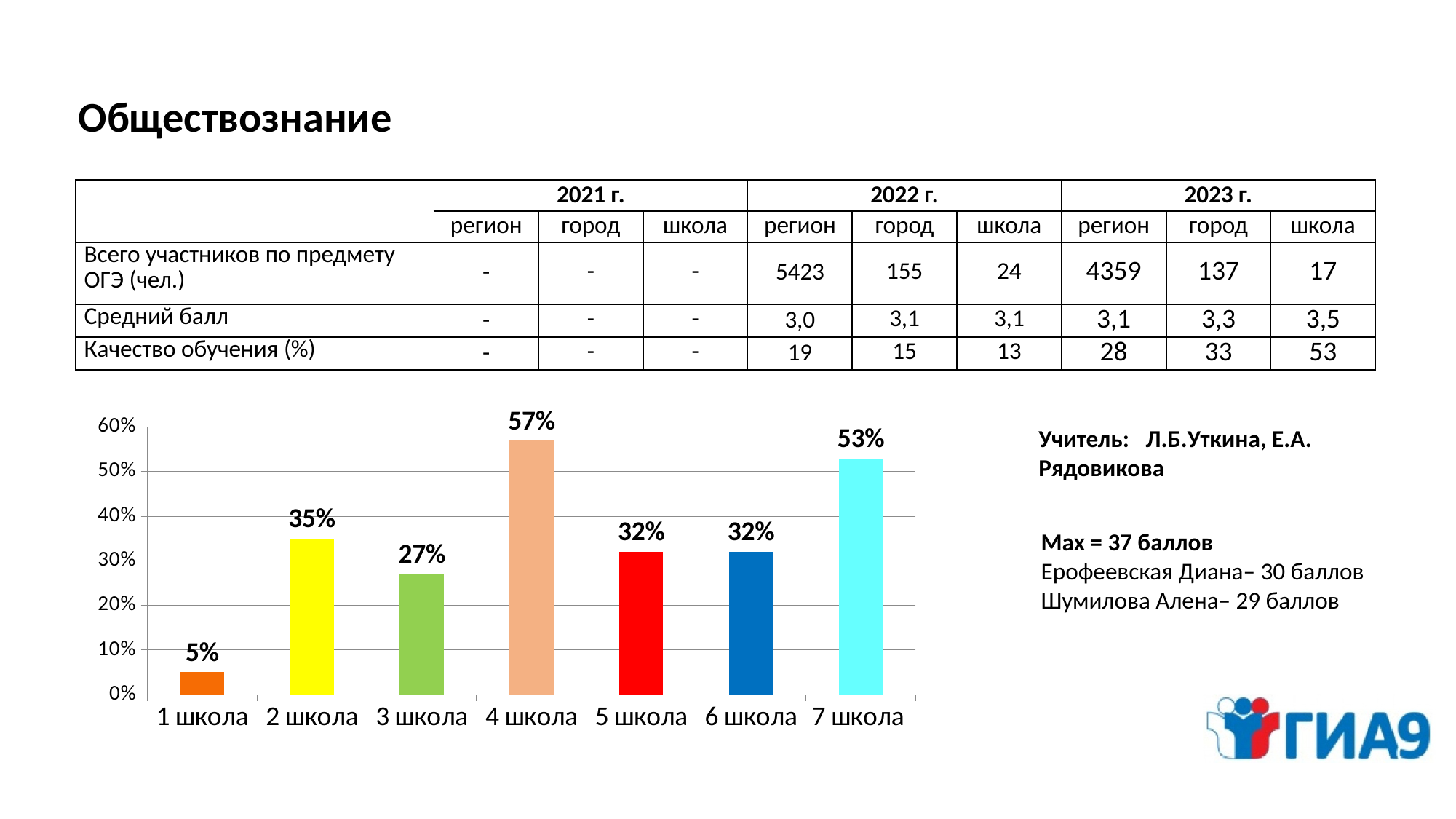
Which school has the highest value in the bar chart? 4 школа What is the value for 1 школа in the bar chart? 5% What is the value for 7 школа in the bar chart? 53% What kind of chart is shown on the slide? bar chart What colour is the bar for 5 школа? red Which school has the lowest value in the bar chart? 1 школа Which is larger, the value for 2 школа or the value for 5 школа? 2 школа What is the value for 4 школа in the bar chart? 57% Is the value for 3 школа greater or less than 30%? less How many schools are shown on the x axis of the bar chart? 7 What is the difference between the values for 4 школа and 7 школа? 4% What is the difference between the values for 2 школа and 3 школа? 8%